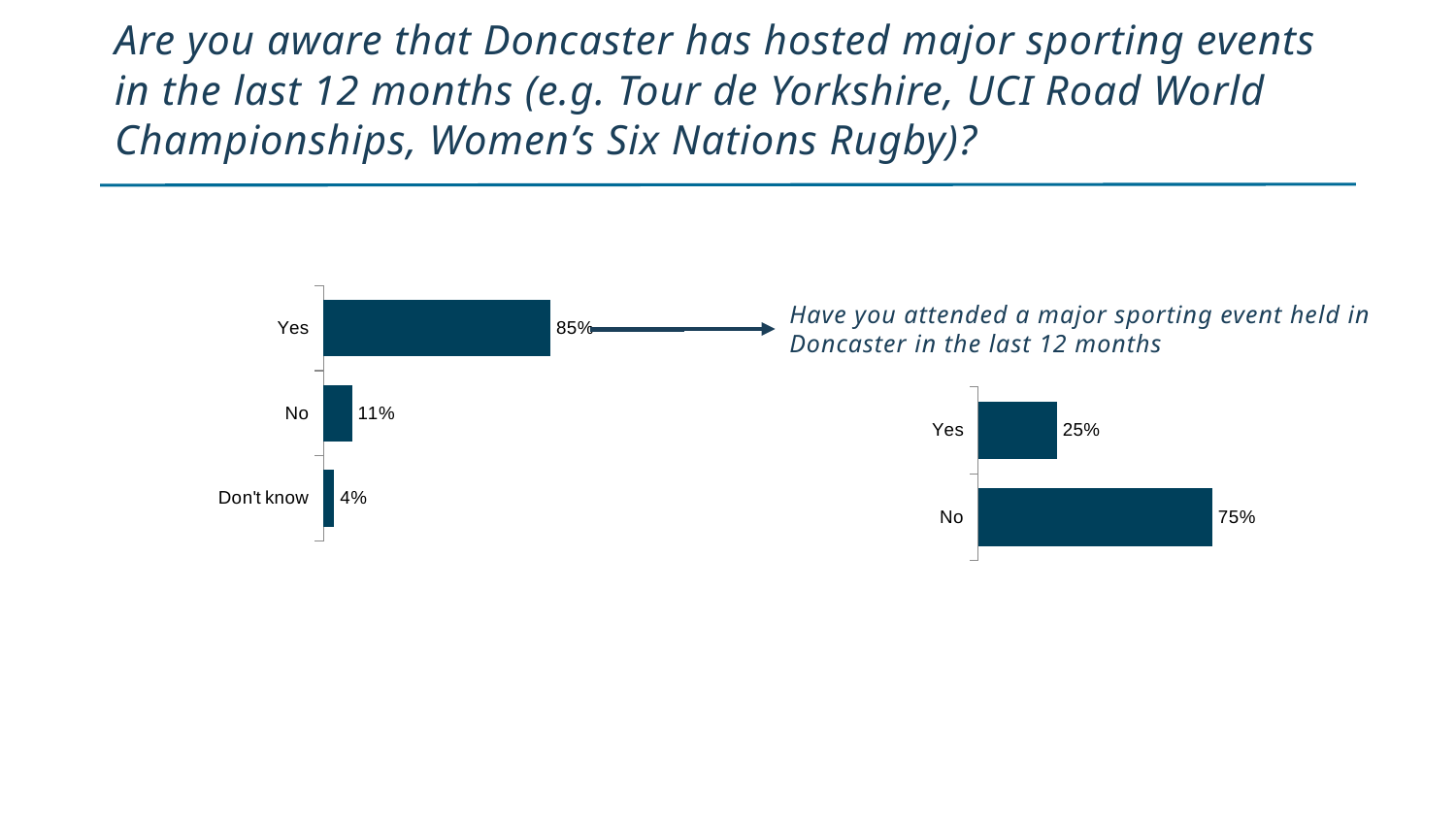
In the right chart (attended a major sporting event in Doncaster), what percentage answered Yes? 25% In the right chart (attended a major sporting event in Doncaster), what is the difference between the No and Yes percentages? 50% In the left chart (awareness of major sporting events), what is the difference between the Yes and No percentages? 74% In the right chart (attended a major sporting event in Doncaster), which response is higher, Yes or No? No In the left chart (awareness of major sporting events), how many response categories are shown? 3 In the left chart (awareness of major sporting events), what percentage answered Yes? 85% In the right chart (attended a major sporting event in Doncaster), what percentage answered No? 75% In the left chart (awareness of major sporting events), which response has the lowest percentage? Don't know In the left chart (awareness of major sporting events), what percentage answered No? 11% In the left chart (awareness of major sporting events), what percentage answered Don't know? 4% What type of chart is used on the left to show awareness of major sporting events? Bar chart What is the title of the chart on the right of the slide? Have you attended a major sporting event held in Doncaster in the last 12 months